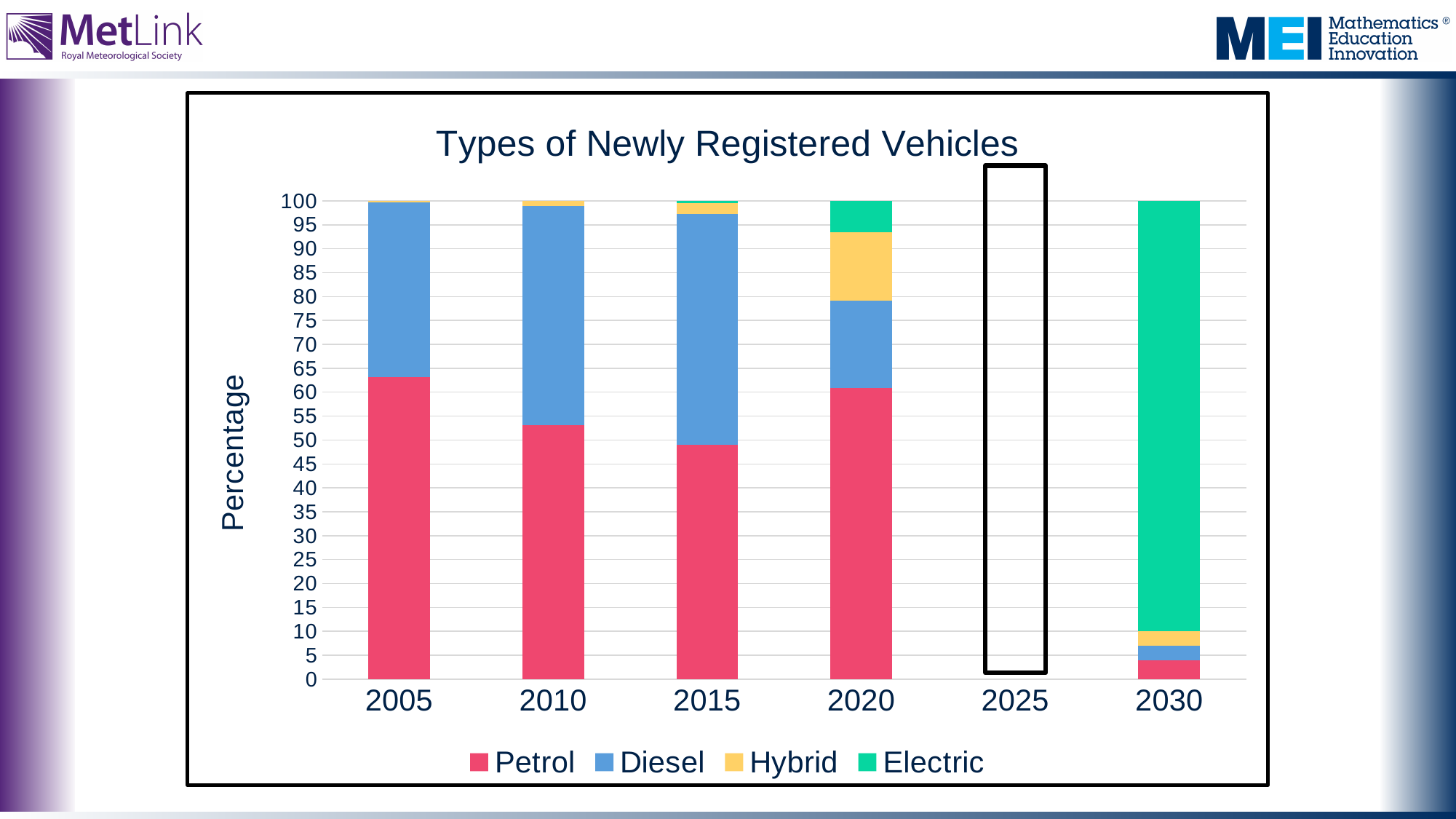
What is the title of the chart? Types of Newly Registered Vehicles Does the Electric share rise or fall from 2020 to 2030? Rise How many years are labelled on the x axis? 6 Is the Electric share in 2030 greater or less than 80 percentage points? greater Which year has the smallest Petrol share? 2030 Which year has the larger Petrol share, 2005 or 2010? 2005 Which year has the largest Electric share? 2030 What kind of chart is shown on the slide? Stacked bar chart How many series does the legend list? 4 Is the Petrol value for 2030 greater or less than 10? less Is the Petrol value for 2005 greater or less than 60? greater Which series is shown in green in the legend? Electric